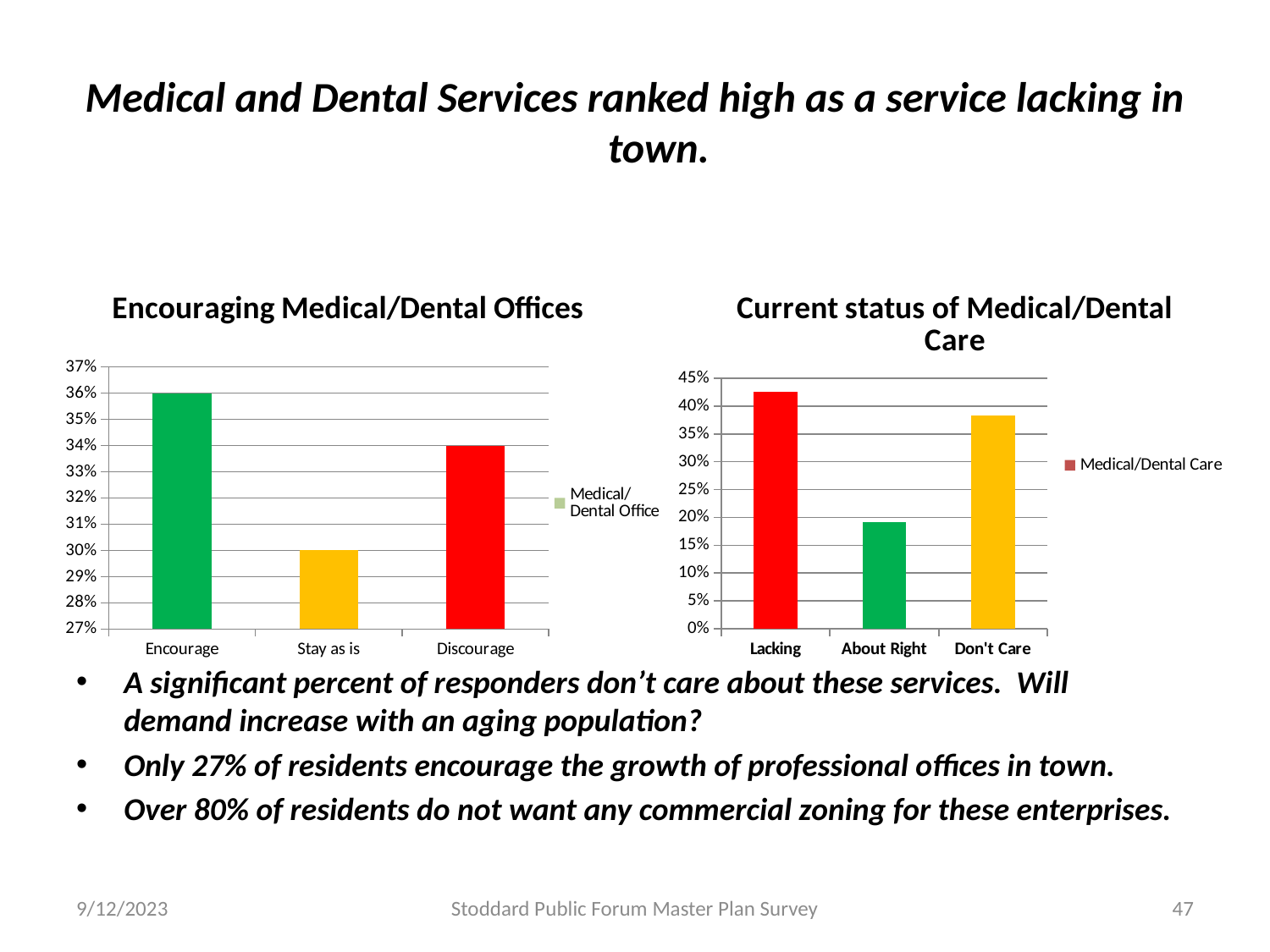
On the 'Current status of Medical/Dental Care' chart, which category has the lowest value? About Right On the 'Current status of Medical/Dental Care' chart, which category has the highest value? Lacking On the 'Encouraging Medical/Dental Offices' chart, which category has the lowest value? Stay as is On the 'Encouraging Medical/Dental Offices' chart, which category has the highest value? Encourage What kind of chart is the 'Current status of Medical/Dental Care' chart? bar chart On the 'Encouraging Medical/Dental Offices' chart, what is the difference between Encourage and Discourage? 2% On the 'Encouraging Medical/Dental Offices' chart, how many categories are shown? 3 On the 'Current status of Medical/Dental Care' chart, is the value for About Right greater or less than 20%? less On the 'Encouraging Medical/Dental Offices' chart, what is the value for Stay as is? 30% What series name does the legend of the 'Current status of Medical/Dental Care' chart list? Medical/Dental Care On the 'Current status of Medical/Dental Care' chart, is the value for Lacking greater or less than 40%? greater On the 'Encouraging Medical/Dental Offices' chart, what is the value for Encourage? 36%